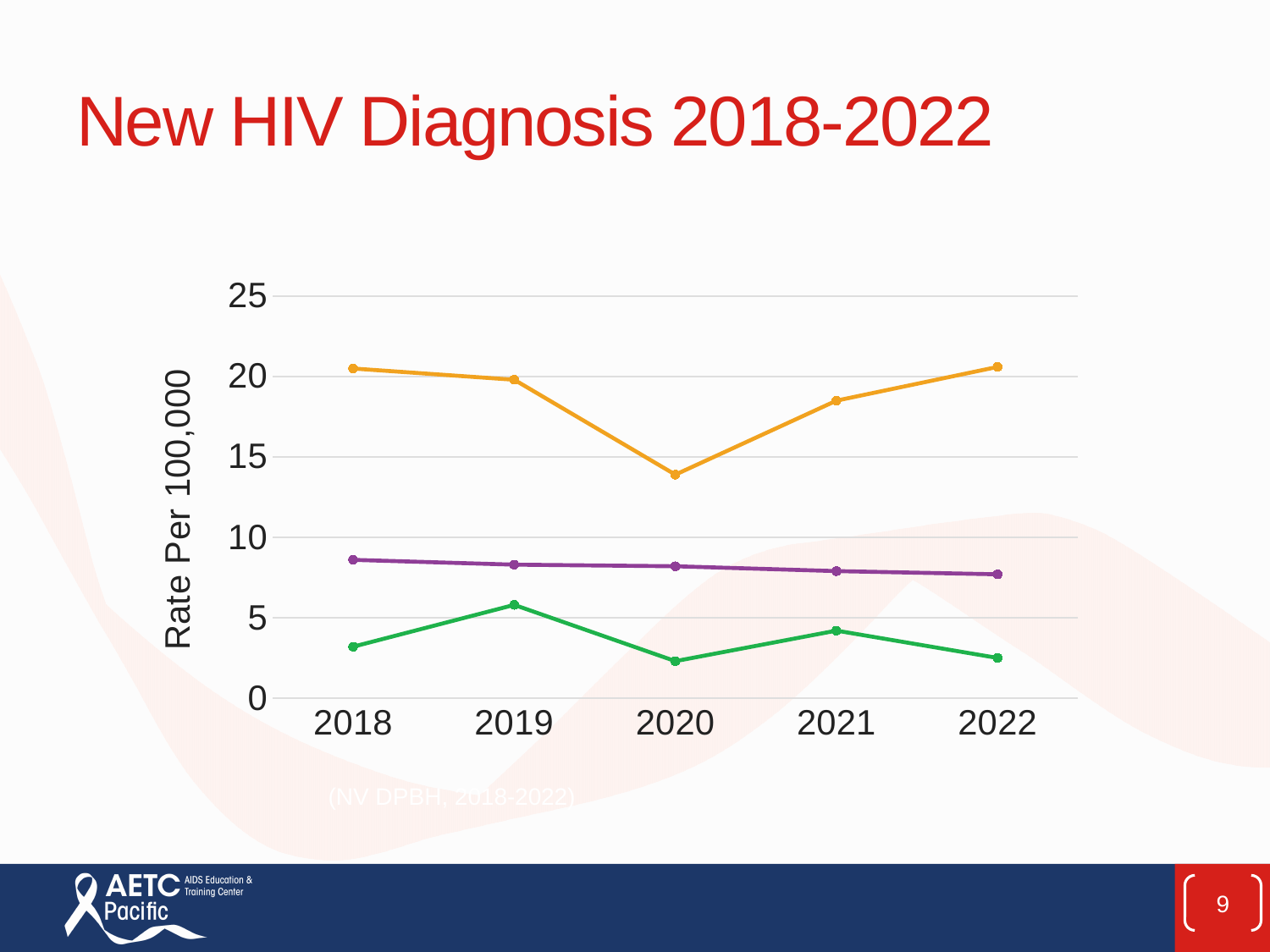
Is the value of the purple line in 2018 greater or less than 10? less How many lines are plotted on the chart? 3 Is the value of the orange line in 2021 greater or less than 20? less In 2020, which line has the higher value, the orange line or the purple line? orange What type of chart is shown on the slide? line chart In which year does the orange line reach its lowest value? 2020 What is the title of the y axis? Rate Per 100,000 Is the value of the green line in 2019 greater or less than 5? greater Does the purple line rise or fall from 2018 to 2022? fall In which year does the green line reach its highest value? 2019 How many years are plotted along the x axis? 5